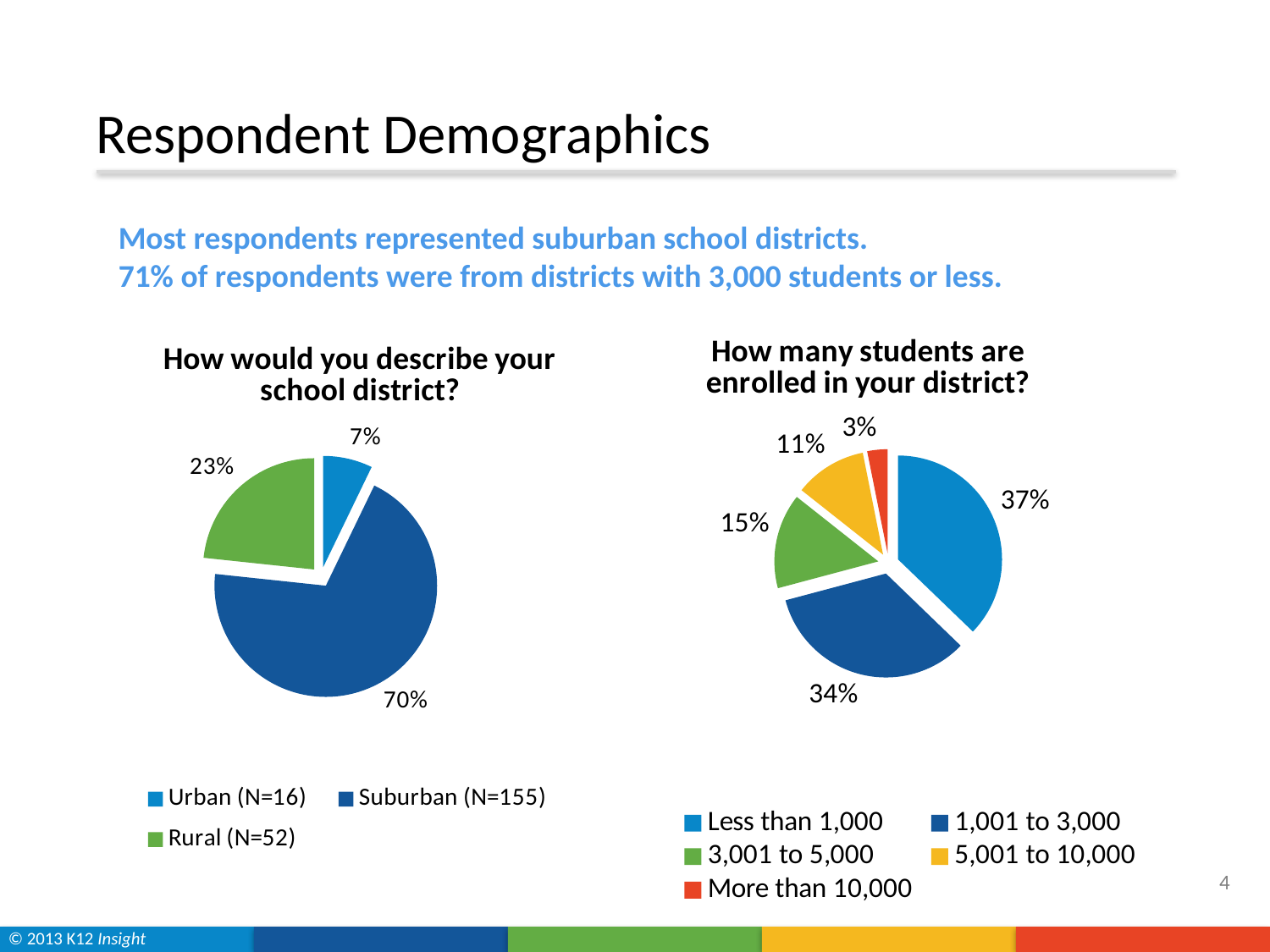
In the chart titled "How would you describe your school district?", what colour is the Rural (N=52) slice? Green In the chart titled "How would you describe your school district?", what is the difference in percentage points between the suburban and rural shares? 47 What kind of chart is used for "How many students are enrolled in your district?"? Pie chart In the chart titled "How many students are enrolled in your district?", how many categories does the legend list? 5 In the chart titled "How would you describe your school district?", which category has the smallest share? Urban (N=16) In the chart titled "How many students are enrolled in your district?", which category has the largest share? Less than 1,000 In the chart titled "How would you describe your school district?", what percentage of respondents were from suburban districts? 70% In the chart titled "How many students are enrolled in your district?", what percentage of respondents were from districts with more than 10,000 students? 3% In the chart titled "How many students are enrolled in your district?", which is larger: the share for 3,001 to 5,000 or the share for 5,001 to 10,000? 3,001 to 5,000 In the chart titled "How would you describe your school district?", how many categories does the legend list? 3 In the chart titled "How many students are enrolled in your district?", what percentage of respondents were from districts with 1,001 to 3,000 students? 34% In the chart titled "How would you describe your school district?", what percentage of respondents were from rural districts? 23%